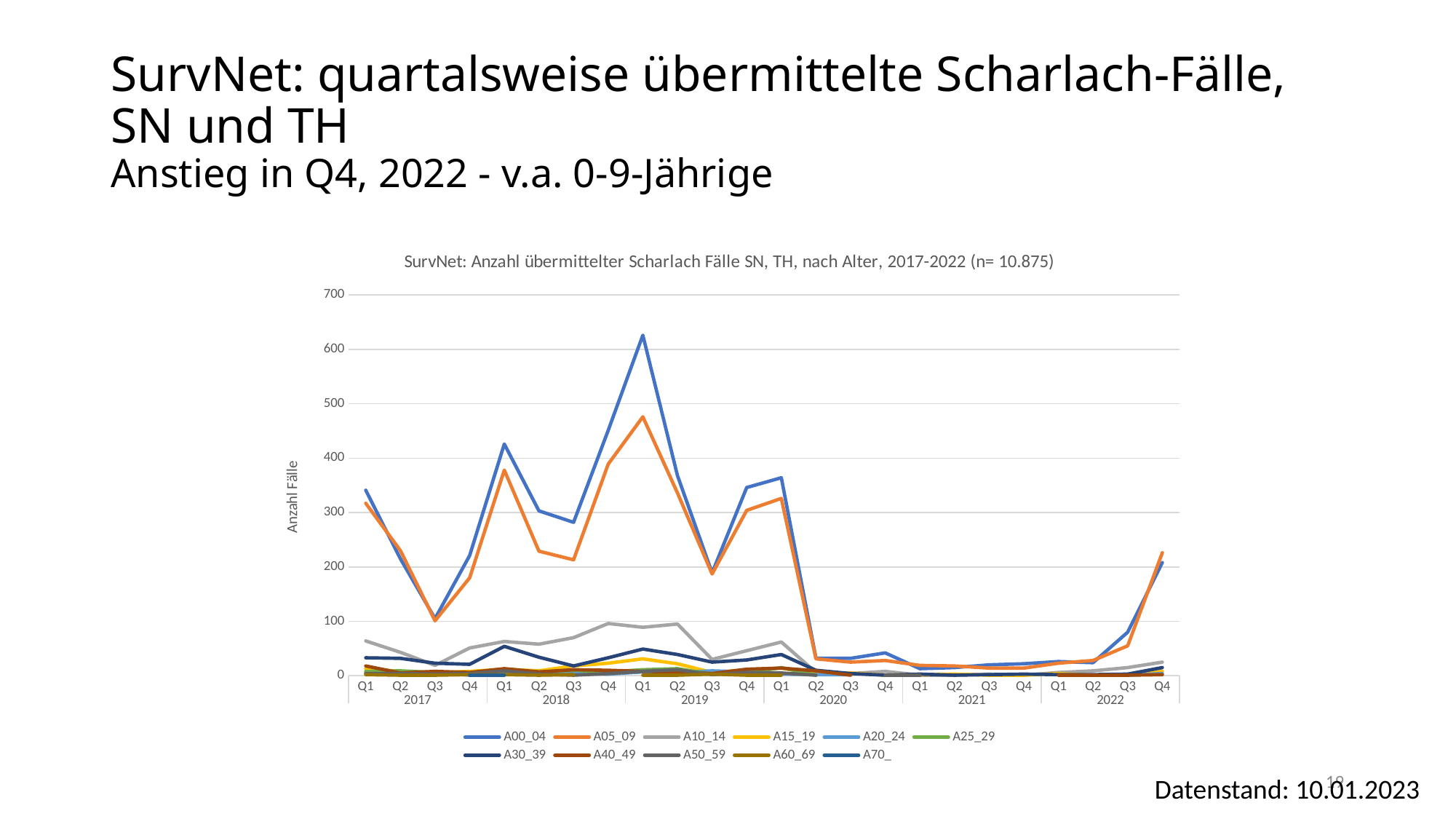
Which series reaches the highest value in the chart? A00_04 Is the value for A05_09 in Q1 2019 greater or less than 500? less Is the value for A00_04 in Q4 2019 greater or less than 300? greater What kind of chart is shown on the slide? line chart Is the value for A00_04 in Q1 2018 greater or less than 400? greater How many series does the legend list? 11 In Q1 2019, which series has the larger value, A00_04 or A05_09? A00_04 In which quarter does the A00_04 series reach its peak? Q1 2019 What is the label of the y axis? Anzahl Fälle How many quarterly data points are plotted along the x axis? 24 Do the values for A00_04 rise or fall from Q2 2022 to Q4 2022? rise